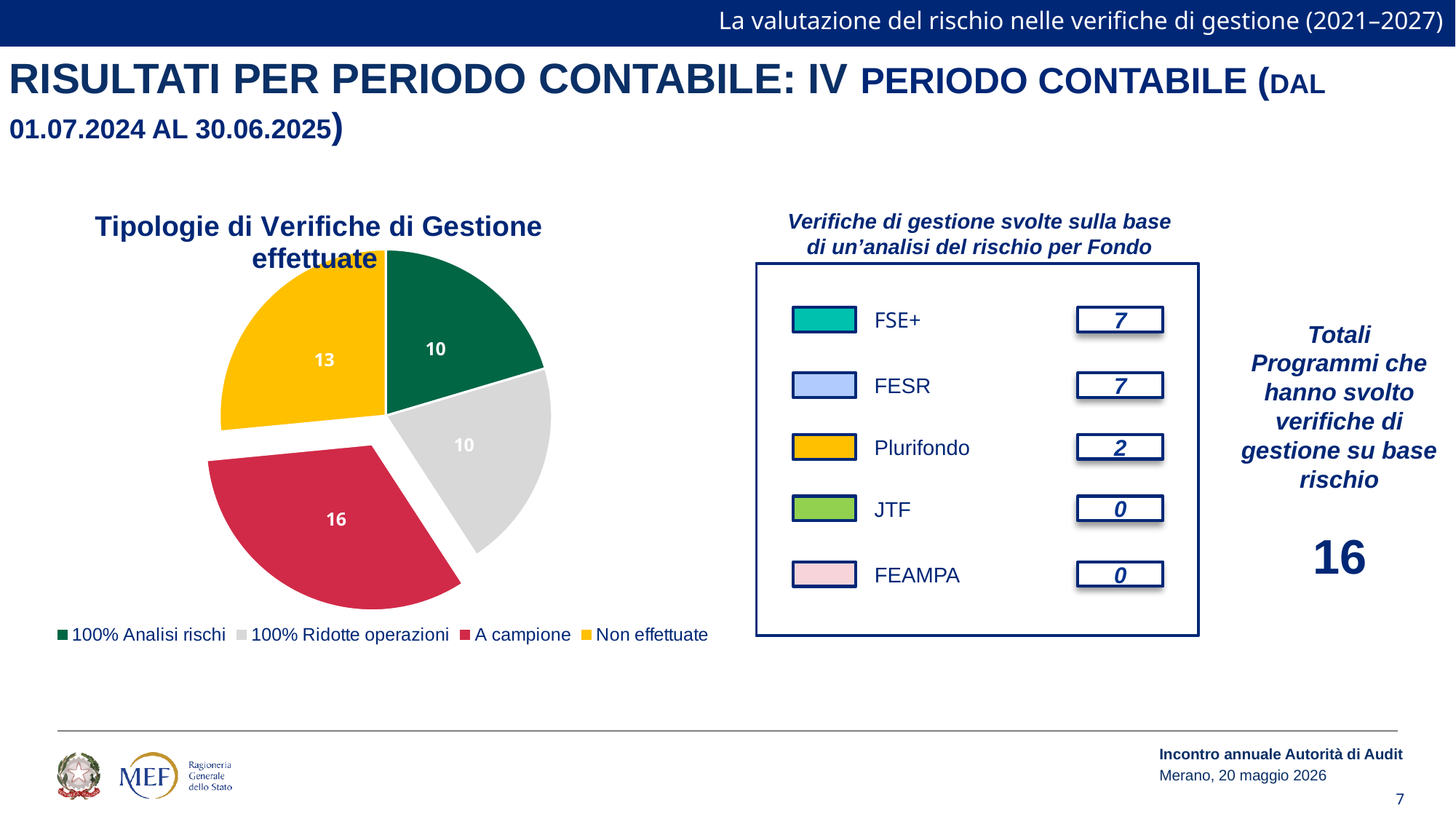
What is the difference between the values for 'Non effettuate' and '100% Analisi rischi' in the pie chart? 3 What is the difference between the values for 'A campione' and 'Non effettuate' in the pie chart? 3 How many categories does the pie chart show? 4 In the pie chart, what is the value for '100% Analisi rischi'? 10 In the pie chart, what is the value for 'Non effettuate'? 13 In the pie chart, which is larger: 'Non effettuate' or '100% Ridotte operazioni'? Non effettuate Which category has the largest slice in the pie chart? A campione What colour is the 'A campione' slice in the pie chart? Red What kind of chart is 'Tipologie di Verifiche di Gestione effettuate'? Pie chart In the pie chart 'Tipologie di Verifiche di Gestione effettuate', what is the value for 'A campione'? 16 In the pie chart, what is the value for '100% Ridotte operazioni'? 10 What is the total of all slices in the pie chart? 49